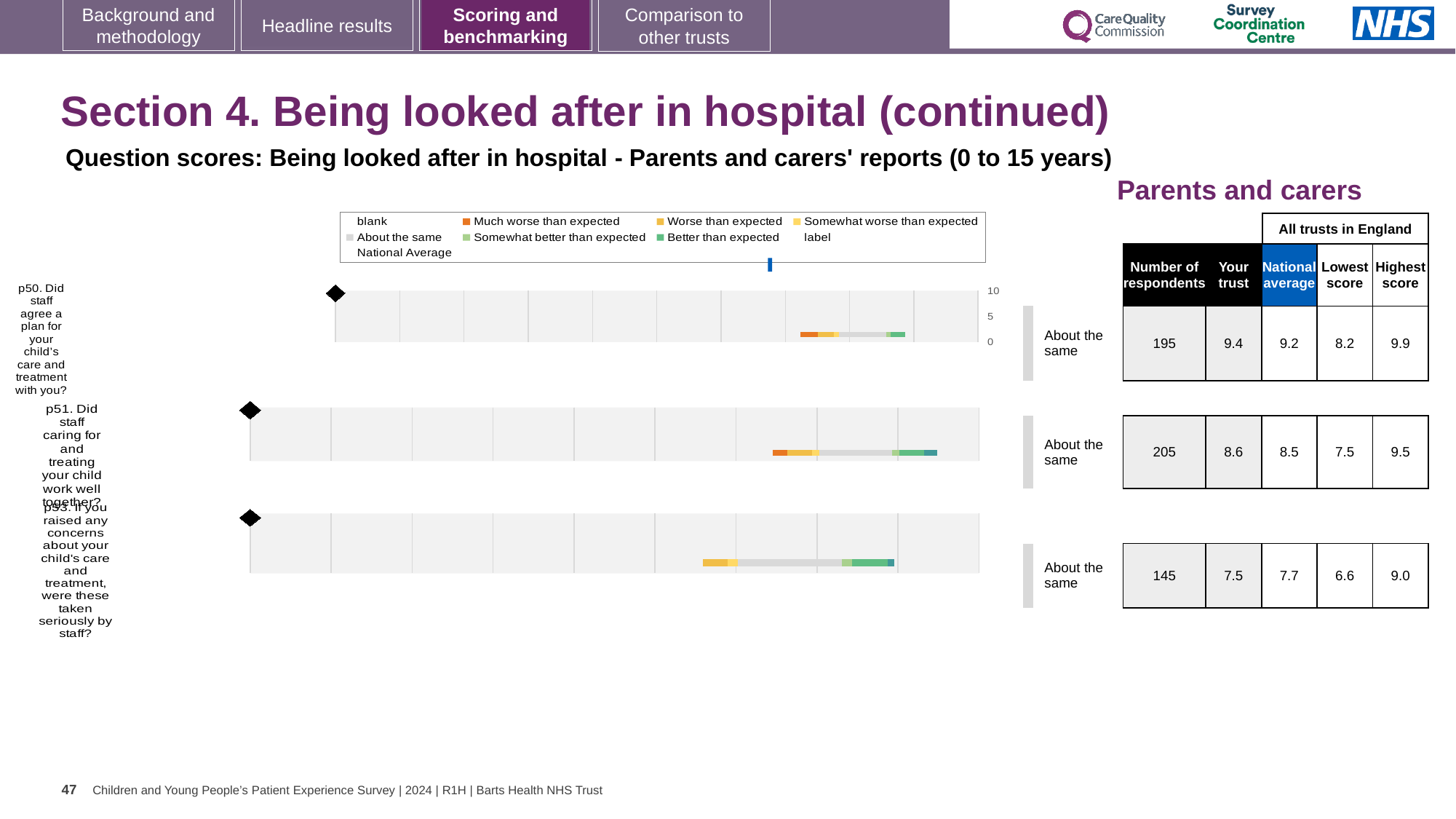
For question p51, which is larger: the 'Your trust' score or the national average? Your trust How many questions are plotted on this slide? 3 What is the lowest score across all trusts in England for question p51? 7.5 How many respondents are shown for question p53 (If you raised any concerns about your child's care and treatment, were these taken seriously by staff?)? 145 Which of the three questions has the highest 'Your trust' score? p50 What benchmark category is shown for all three questions? About the same Which of the three questions has the lowest 'Your trust' score? p53 For question p50, what is the difference between the highest score and the lowest score across all trusts in England? 1.7 For question p53, which is larger: the 'Your trust' score or the national average? National average What is the national average score for question p51 (Did staff caring for and treating your child work well together?)? 8.5 What is the 'Your trust' score for question p50 (Did staff agree a plan for your child's care and treatment with you?)? 9.4 What kind of chart is used to show the question scores? Bar chart